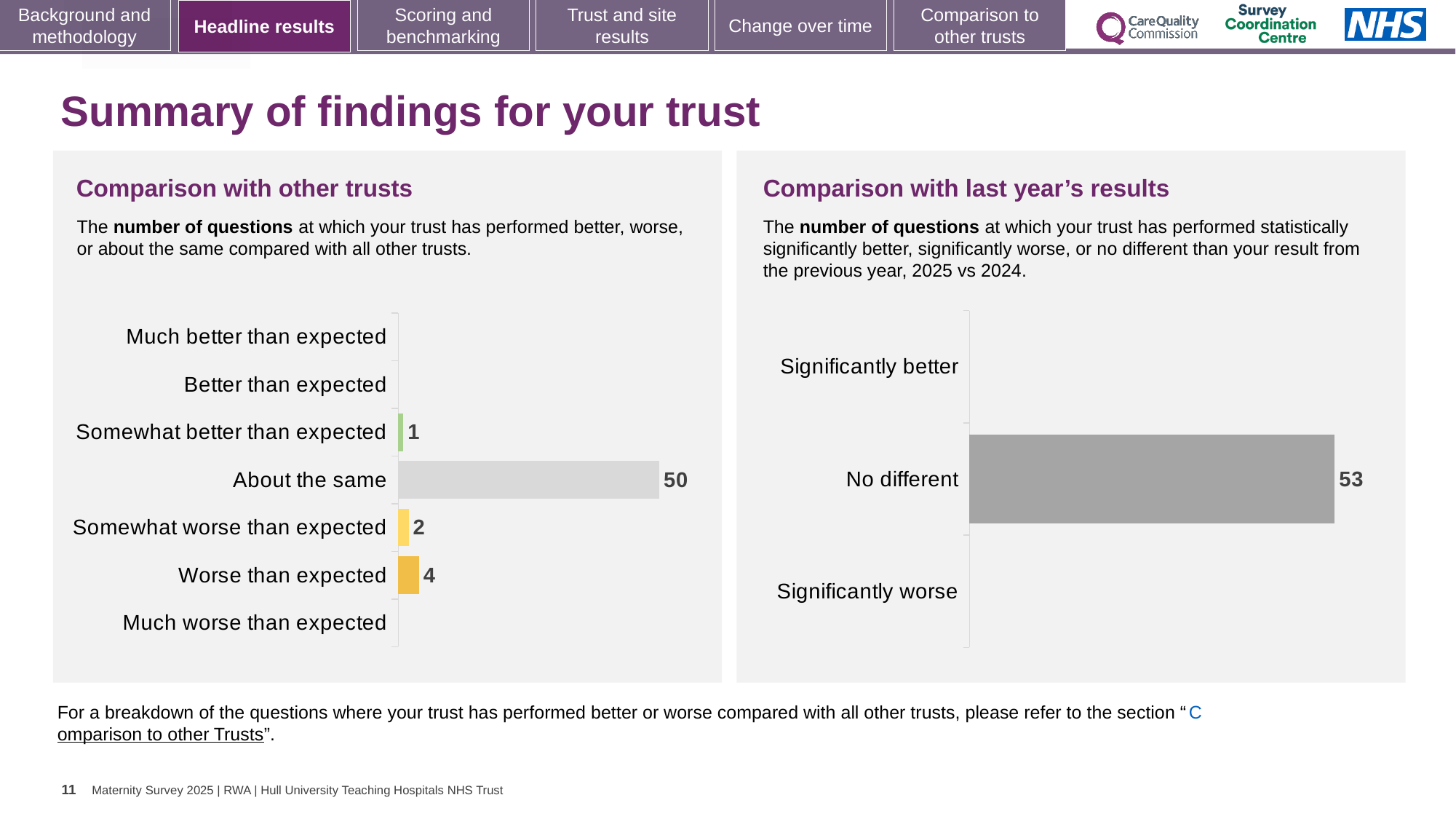
In the 'Comparison with other trusts' chart, what is the value for 'Worse than expected'? 4 In the 'Comparison with other trusts' chart, what is the value for 'About the same'? 50 What is the title of the chart on the left side of the slide? Comparison with other trusts How many categories are listed on the 'Comparison with other trusts' chart? 7 How many categories are listed on the 'Comparison with last year's results' chart? 3 In the 'Comparison with other trusts' chart, which is larger: 'Worse than expected' or 'Somewhat worse than expected'? Worse than expected In the 'Comparison with other trusts' chart, which category has the highest value? About the same What kind of chart is the 'Comparison with last year's results' chart? Bar chart In the 'Comparison with other trusts' chart, what is the value for 'Somewhat worse than expected'? 2 In the 'Comparison with other trusts' chart, what is the value for 'Somewhat better than expected'? 1 In the 'Comparison with last year's results' chart, what is the value for 'No different'? 53 In the 'Comparison with other trusts' chart, what is the difference between 'About the same' and 'Worse than expected'? 46